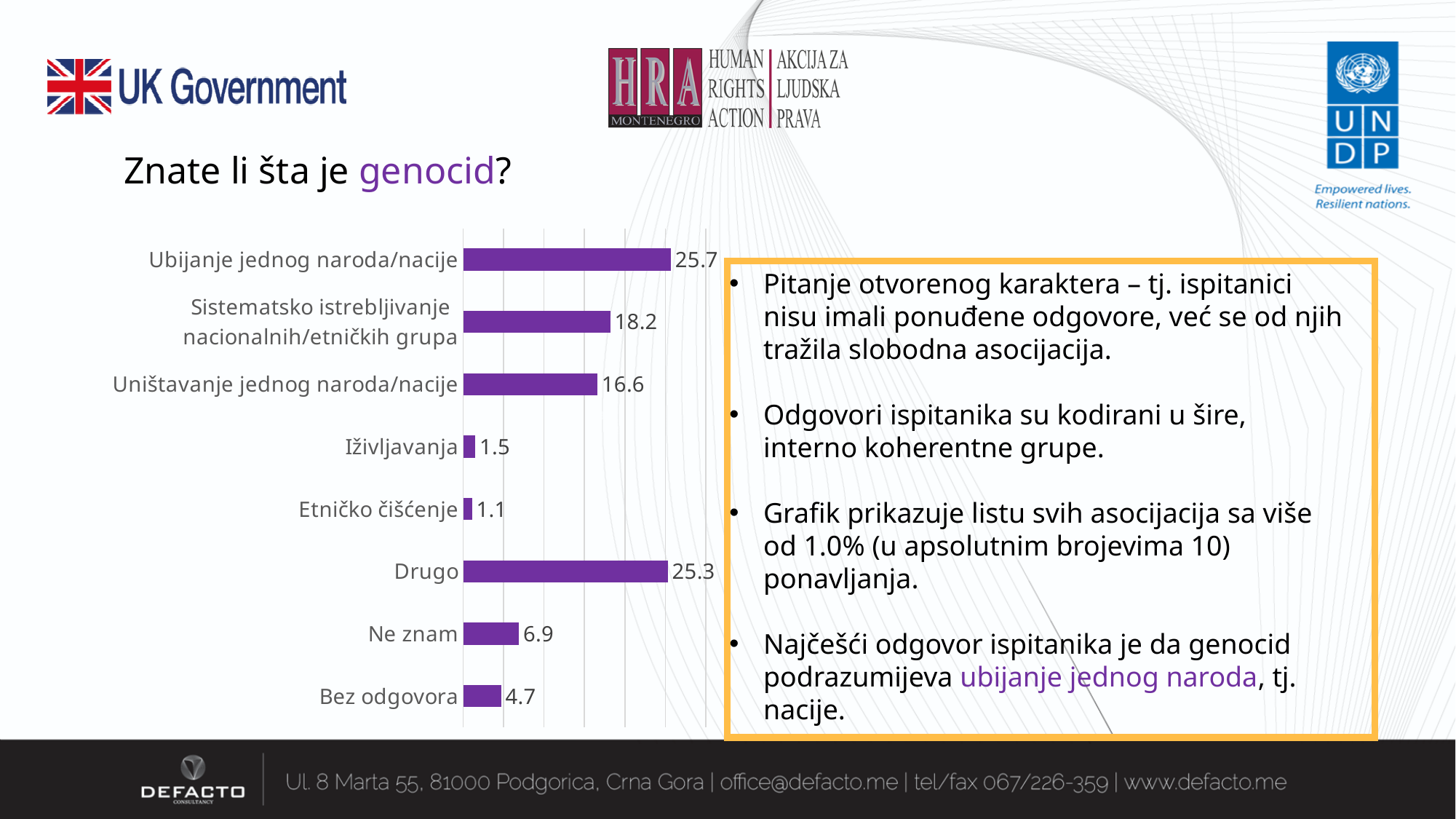
What is the value for "Ubijanje jednog naroda/nacije"? 25.7 Which category has the lowest value? Etničko čišćenje What is the value for "Ne znam"? 6.9 Which category has the highest value? Ubijanje jednog naroda/nacije Which is larger, the value for "Drugo" or the value for "Uništavanje jednog naroda/nacije"? Drugo What is the value for "Bez odgovora"? 4.7 What kind of chart is shown on the slide? Bar chart What is the value for "Etničko čišćenje"? 1.1 How many categories are shown in the chart? 8 What is the difference between the values for "Sistematsko istrebljivanje nacionalnih/etničkih grupa" and "Uništavanje jednog naroda/nacije"? 1.6 What is the difference between the values for "Ne znam" and "Bez odgovora"? 2.2 What colour are the bars in the chart? Purple